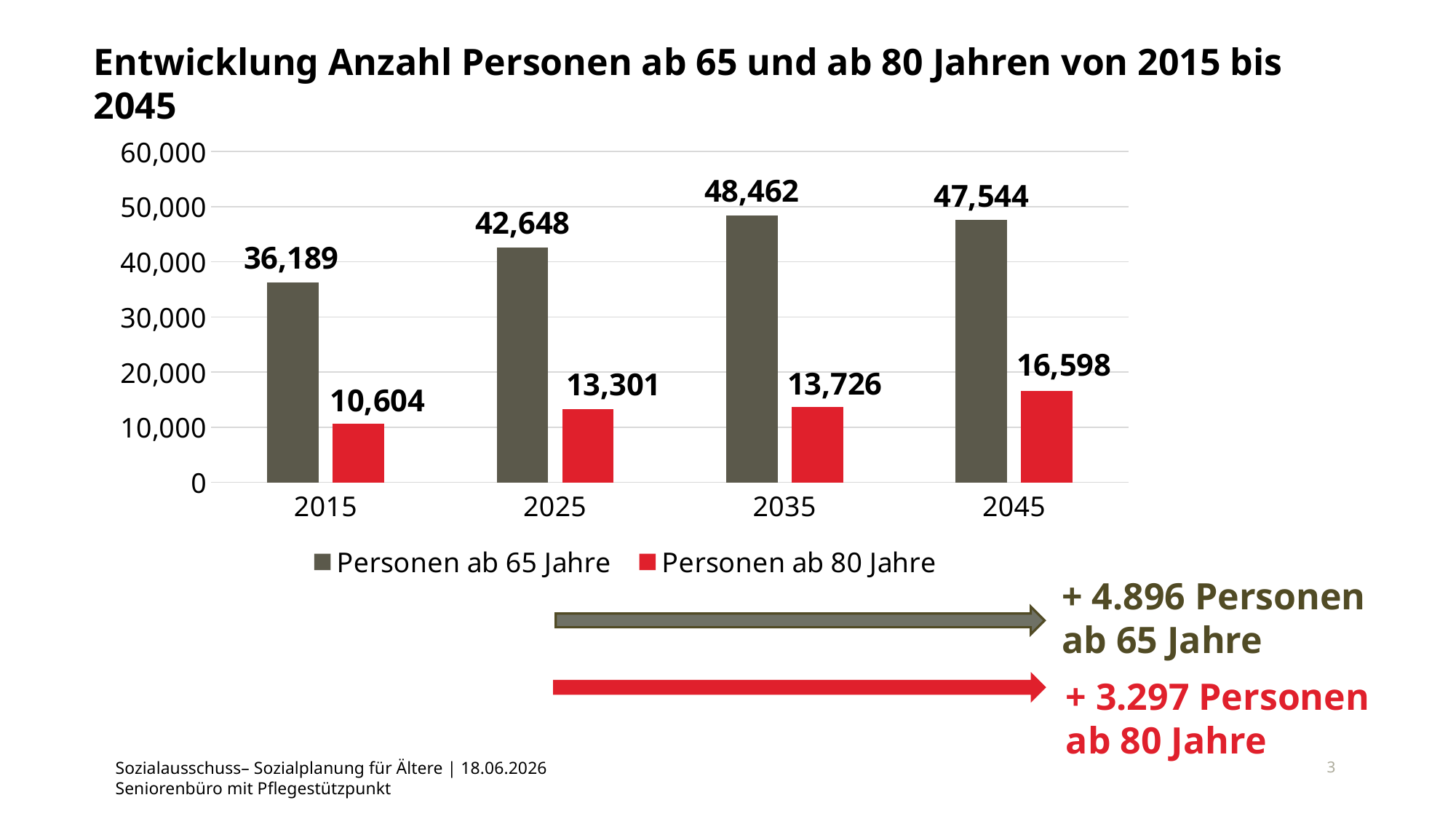
What is the value for Personen ab 65 Jahre in 2015? 36,189 Is the value for Personen ab 65 Jahre in 2025 greater or less than 40,000? greater What is the value for Personen ab 80 Jahre in 2025? 13,301 By how much does the value for Personen ab 80 Jahre in 2045 exceed the value in 2015? 5,994 How many years are shown on the x axis? 4 Which is larger: Personen ab 65 Jahre in 2025 or Personen ab 65 Jahre in 2045? 2045 What kind of chart is shown on the slide? Bar chart In which year is the value for Personen ab 80 Jahre lowest? 2015 In which year is the value for Personen ab 65 Jahre highest? 2035 What is the value for Personen ab 80 Jahre in 2045? 16,598 How many series does the legend list? 2 What is the difference between the Personen ab 65 Jahre values for 2035 and 2045? 918